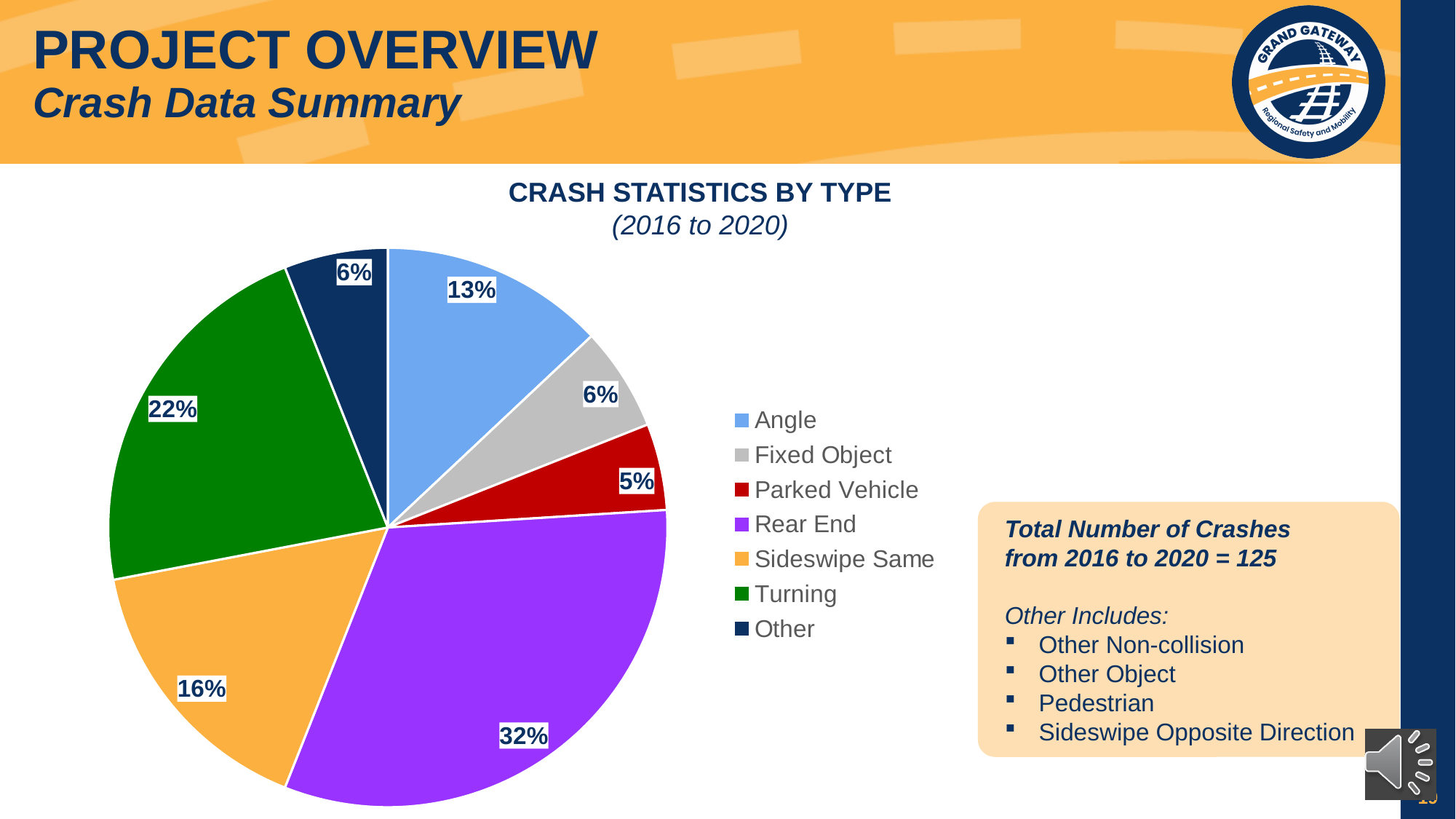
What percentage of crashes are Rear End? 32% What percentage of crashes are Angle? 13% How many crash types are listed in the legend? 7 What type of chart is shown on the slide? pie chart What is the difference in percentage points between Rear End and Turning crashes? 10 What percentage of crashes are Sideswipe Same? 16% Which has a larger share, Angle or Sideswipe Same? Sideswipe Same Which crash type has the smallest share of the pie? Parked Vehicle What percentage of crashes are Turning? 22% Which crash type has the largest share of the pie? Rear End What is the title of the chart? CRASH STATISTICS BY TYPE (2016 to 2020) What percentage of crashes are Parked Vehicle? 5%